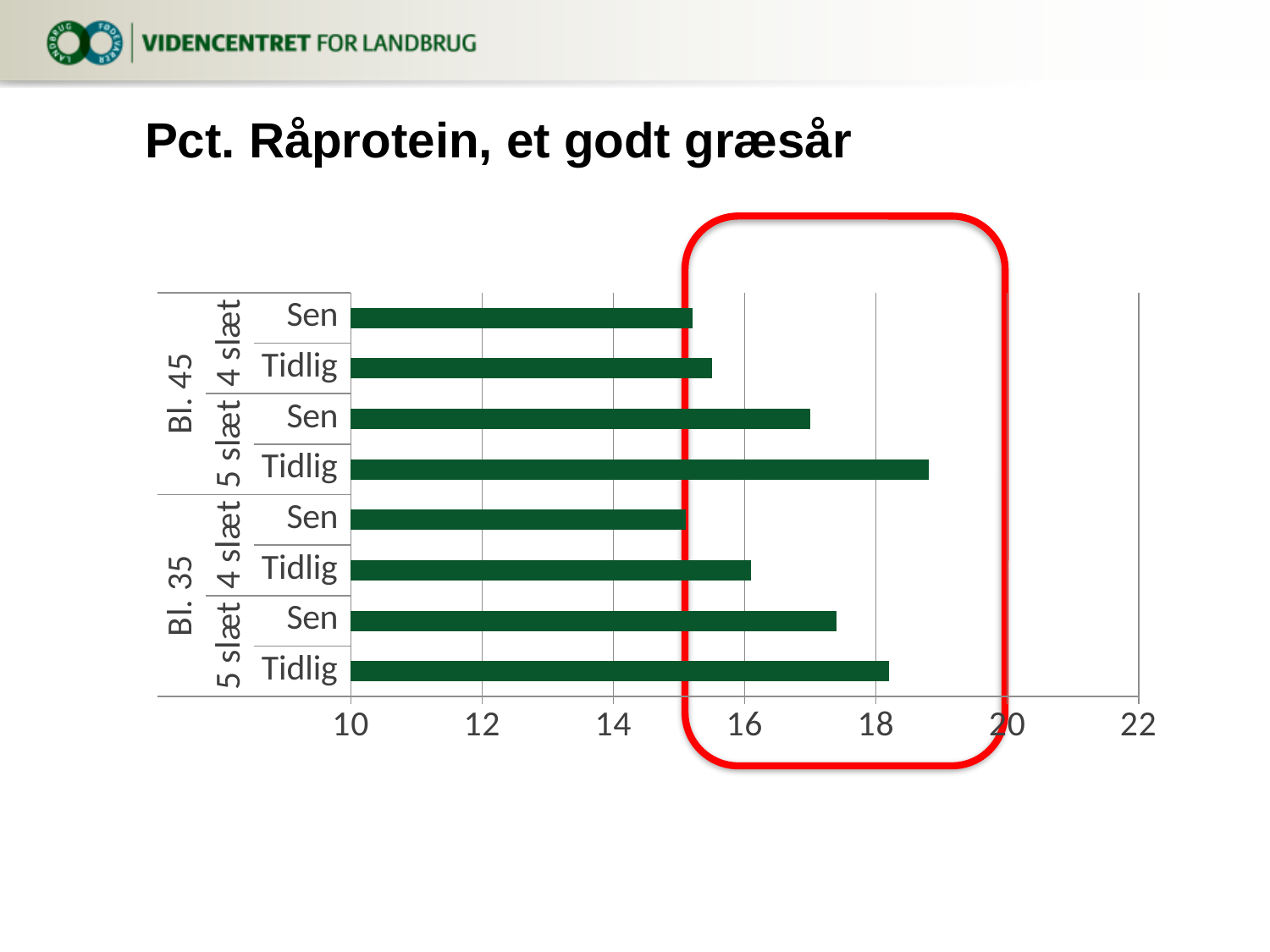
For Bl. 35 with 4 slæt, which is larger: Tidlig or Sen? Tidlig Is the value for Bl. 35, 5 slæt, Sen greater or less than 18? less Is the value for Bl. 45, 5 slæt, Sen greater or less than 16? greater Which bar has the highest value in the chart? Bl. 45, 5 slæt, Tidlig What is the highest value shown on the horizontal axis of the chart? 22 Is the value for Bl. 45, 5 slæt, Tidlig greater or less than 18? greater For Bl. 45 with 5 slæt, which is larger: Tidlig or Sen? Tidlig What is the title of the slide's chart? Pct. Råprotein, et godt græsår What kind of chart is shown on the slide? Bar chart How many bars are plotted in the chart? 8